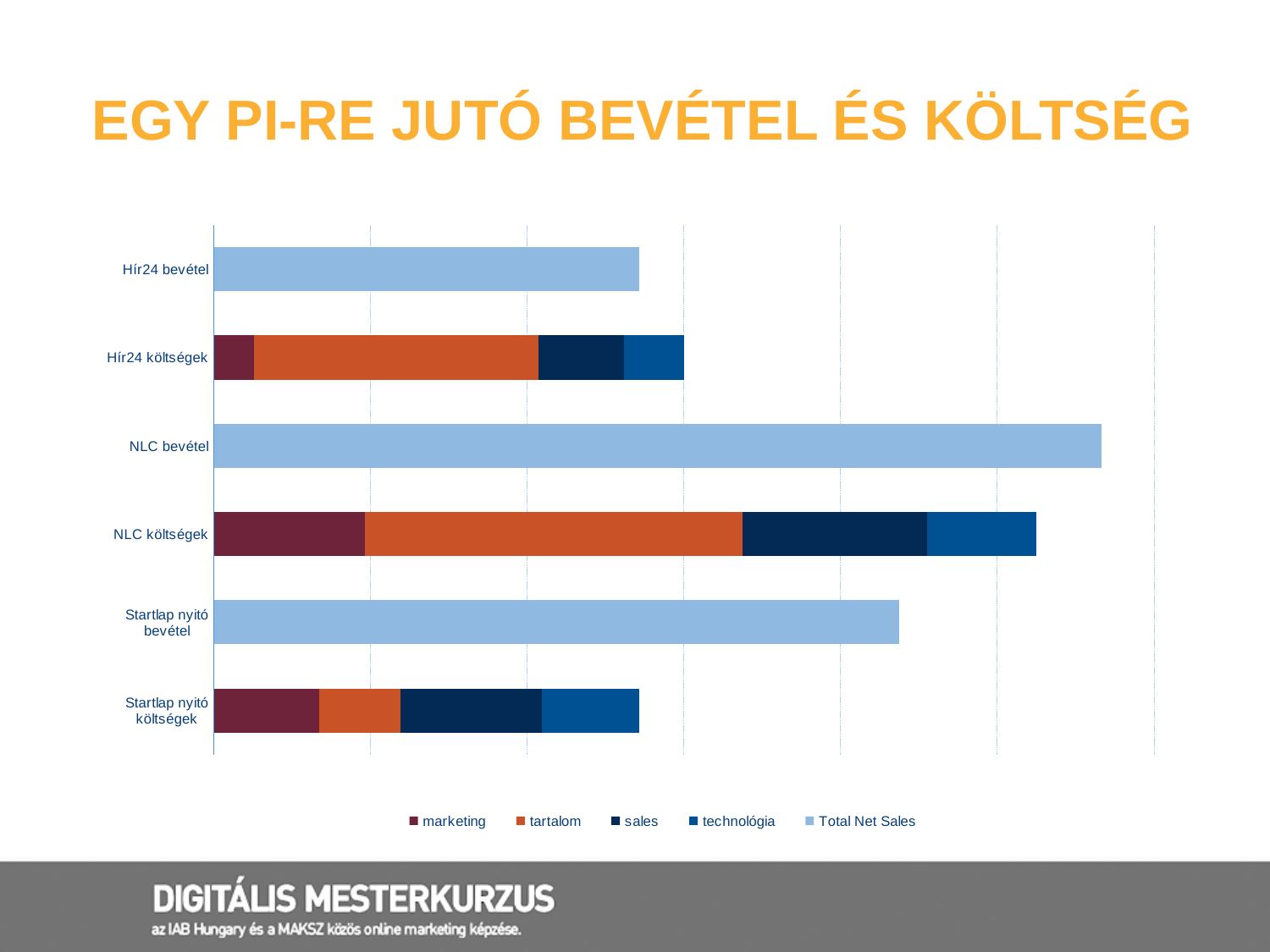
Which legend series is plotted for the bevétel (revenue) bars? Total Net Sales How many stacked segments make up the NLC költségek bar? 4 How many series does the legend list? 5 Which series forms the largest segment of the Startlap nyitó költségek bar? sales How many categories are listed on the vertical axis of the chart? 6 Which is larger, the bar for NLC bevétel or the bar for NLC költségek? NLC bevétel Which is larger, the bar for Startlap nyitó bevétel or the bar for Startlap nyitó költségek? Startlap nyitó bevétel What kind of chart is shown on the slide? bar chart Which category has the longest bar in the chart? NLC bevétel What is the title of the slide containing the chart? EGY PI-RE JUTÓ BEVÉTEL ÉS KÖLTSÉG